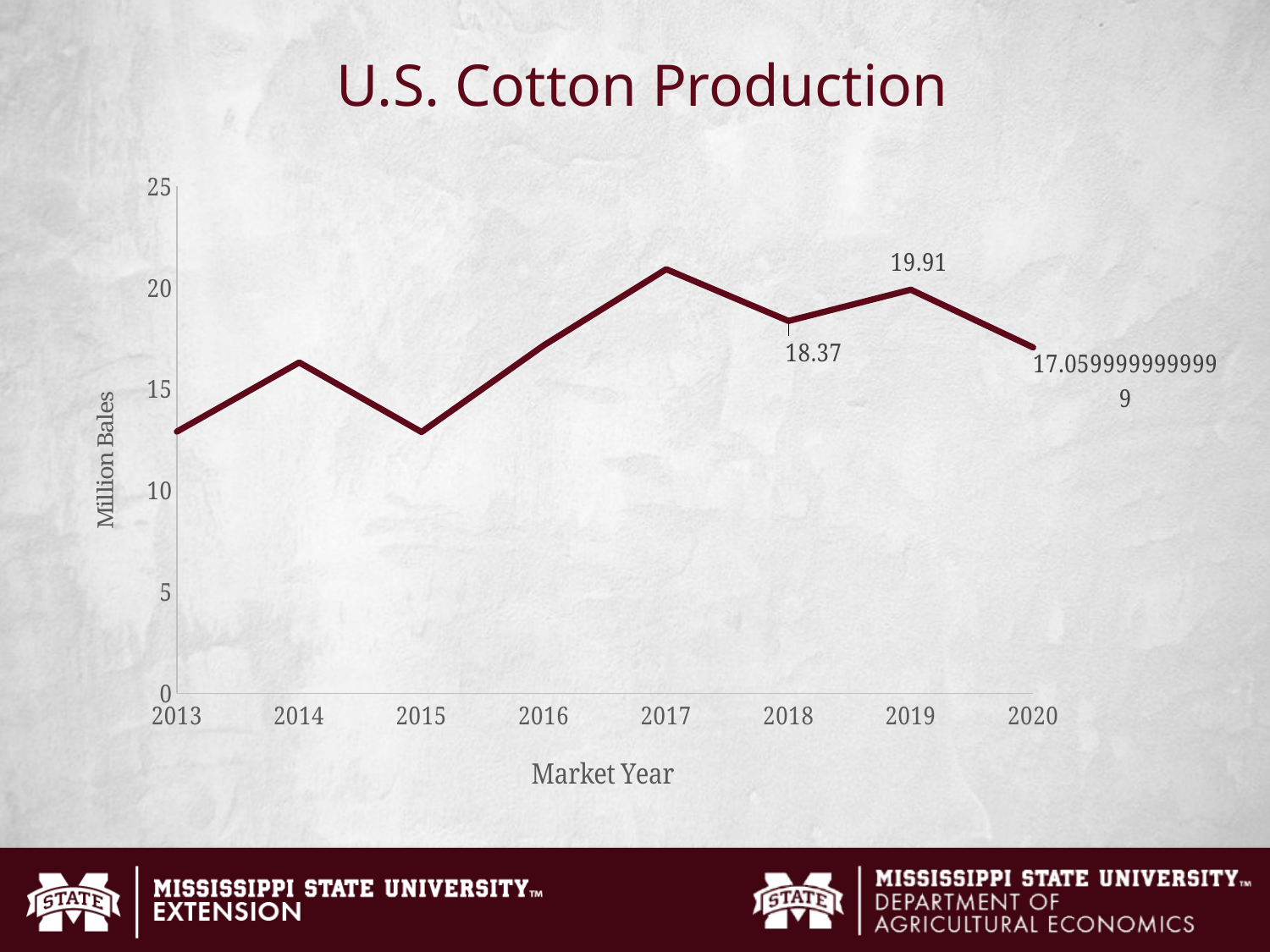
What is the U.S. cotton production value for market year 2019? 19.91 What type of chart is shown on the slide? line chart Is the production value for 2013 greater or less than 15? less Is the production value for 2017 greater or less than 20? greater Is the production value for 2014 greater or less than 15? greater Which market year has the highest cotton production on the chart? 2017 What is the U.S. cotton production value for market year 2018? 18.37 Does production rise or fall from 2019 to 2020? fall What is the label on the vertical axis of the chart? Million Bales Which market year has the larger production value, 2018 or 2019? 2019 How many market years are plotted on the chart? 8 What is the difference between the 2019 and 2018 production values? 1.54